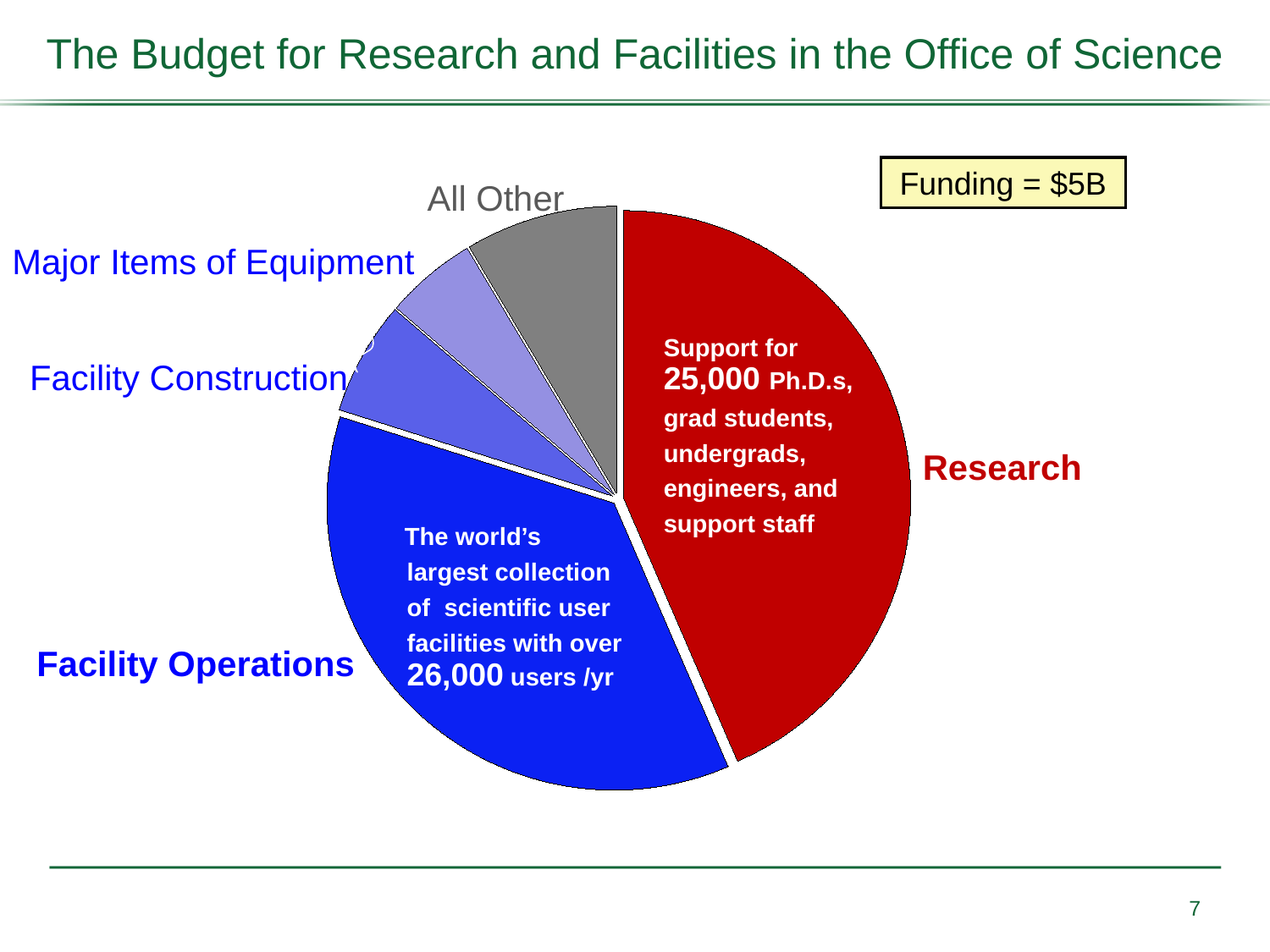
Which is larger, the Facility Operations slice or the Major Items of Equipment slice? Facility Operations What colour is the Research slice of the pie chart? red What kind of chart is shown on the slide? pie chart What total funding amount is shown in the box on the slide? $5B Which is larger, the All Other slice or the Major Items of Equipment slice? All Other Which is larger, the Facility Operations slice or the All Other slice? Facility Operations How many slices does the pie chart have? 5 Which category has the largest slice of the pie chart? Research